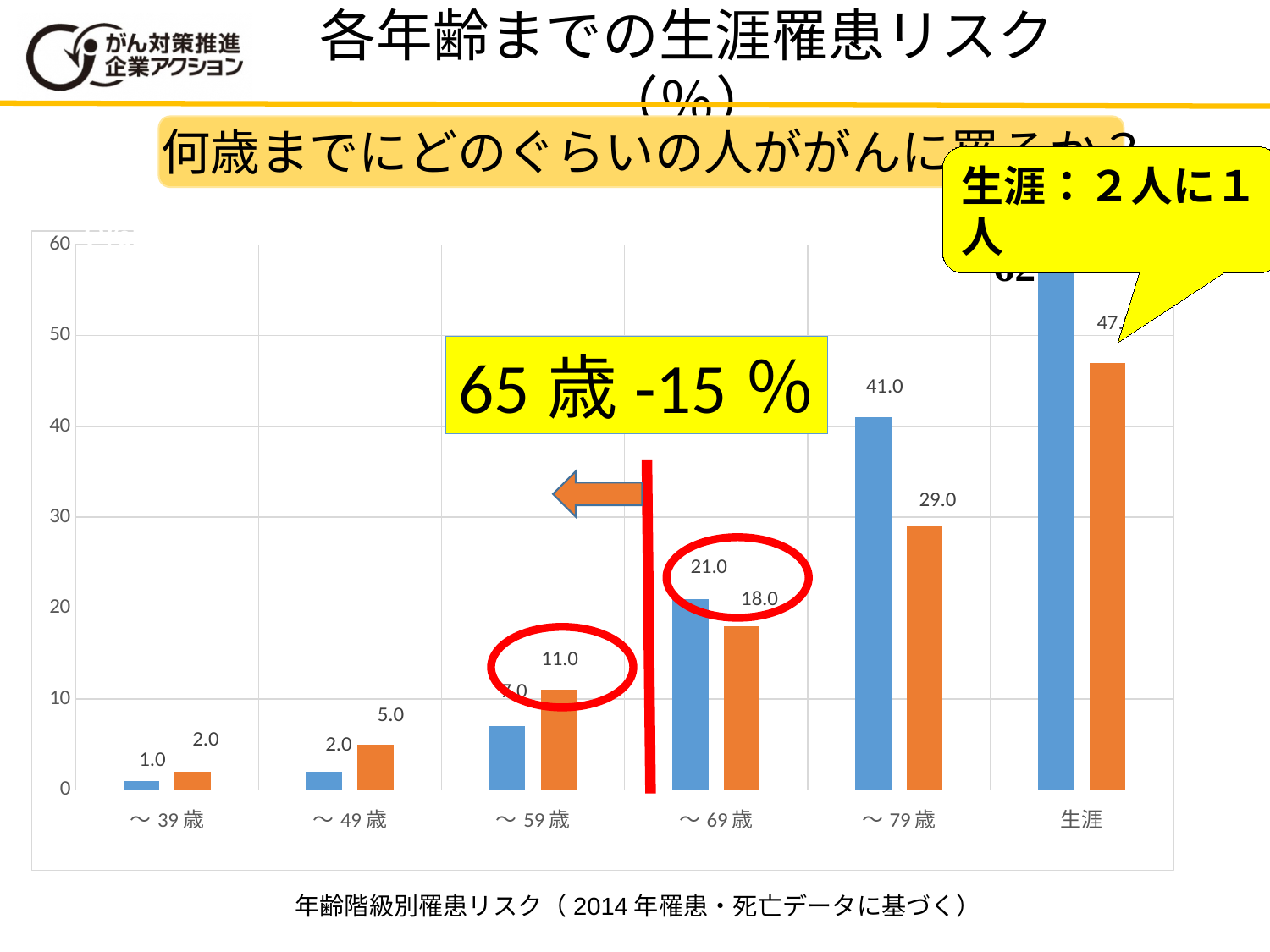
How many age categories are shown on the x axis of the chart? 6 What type of chart is shown on the slide? bar chart What is the value of the blue bar for ～39歳? 1.0 What is the value of the blue bar for ～79歳? 41.0 Which is larger for ～69歳, the blue bar or the orange bar? the blue bar What is the value of the orange bar for ～59歳? 11.0 What is the difference between the blue and orange bars for ～79歳? 12.0 What is the value of the orange bar for ～49歳? 5.0 Do the blue bar values rise or fall from ～39歳 to 生涯? rise What is the value of the orange bar for ～69歳? 18.0 Is the value of the blue bar for 生涯 greater or less than 50? greater What is the value of the blue bar for ～69歳? 21.0